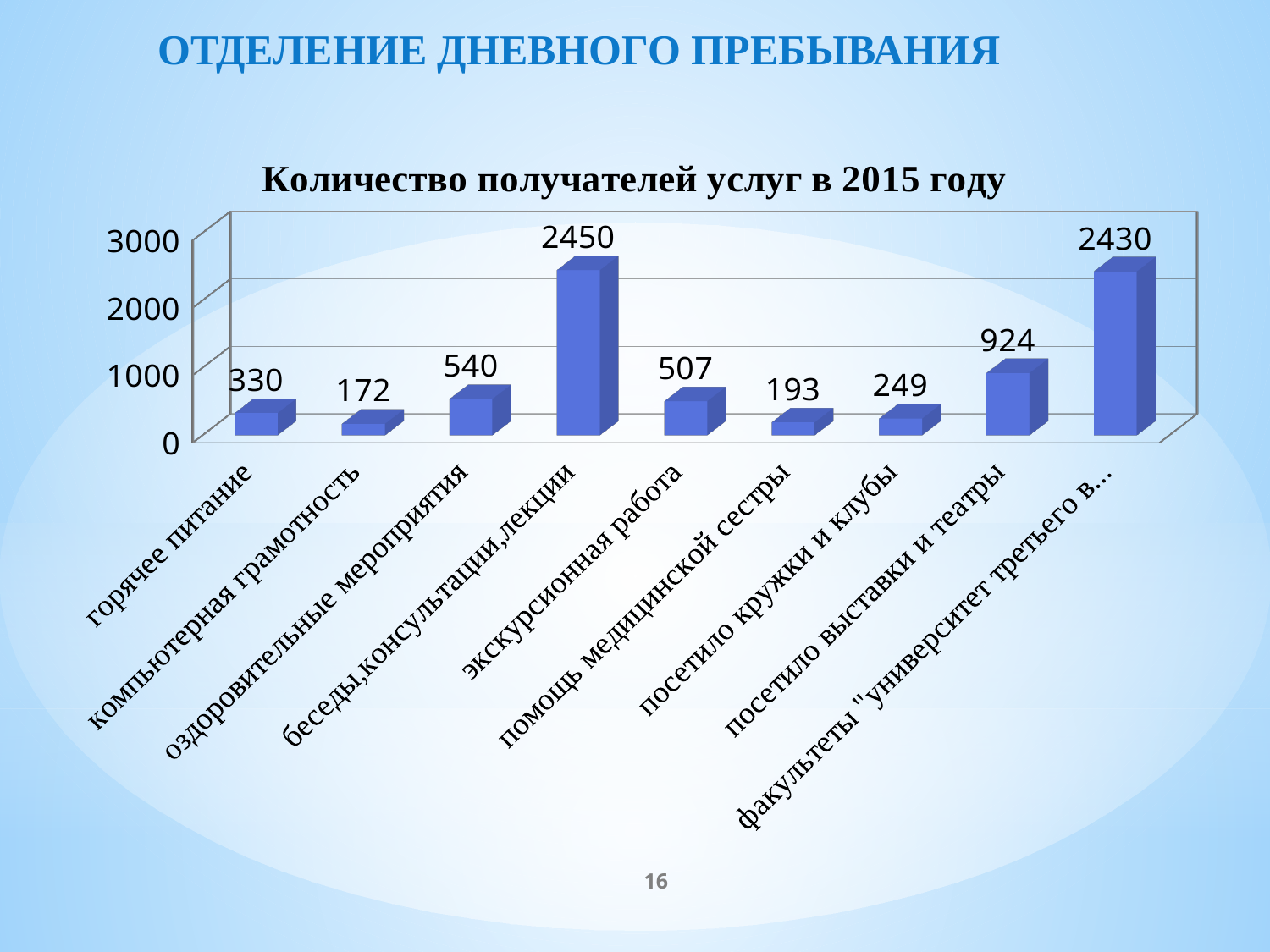
What type of chart is shown on the slide? bar chart Which category has the highest value? беседы,консультации,лекции What is the value for помощь медицинской сестры? 193 What is the value for горячее питание? 330 How many categories are shown in the chart? 9 What is the value for беседы,консультации,лекции? 2450 What is the title of the chart? Количество получателей услуг в 2015 году What is the value for посетило выставки и театры? 924 What is the difference between the values for оздоровительные мероприятия and экскурсионная работа? 33 Which category has the lowest value? компьютерная грамотность Is the value for посетило выставки и театры greater or less than 1000? less Which is larger, the value for посетило кружки и клубы or the value for горячее питание? горячее питание